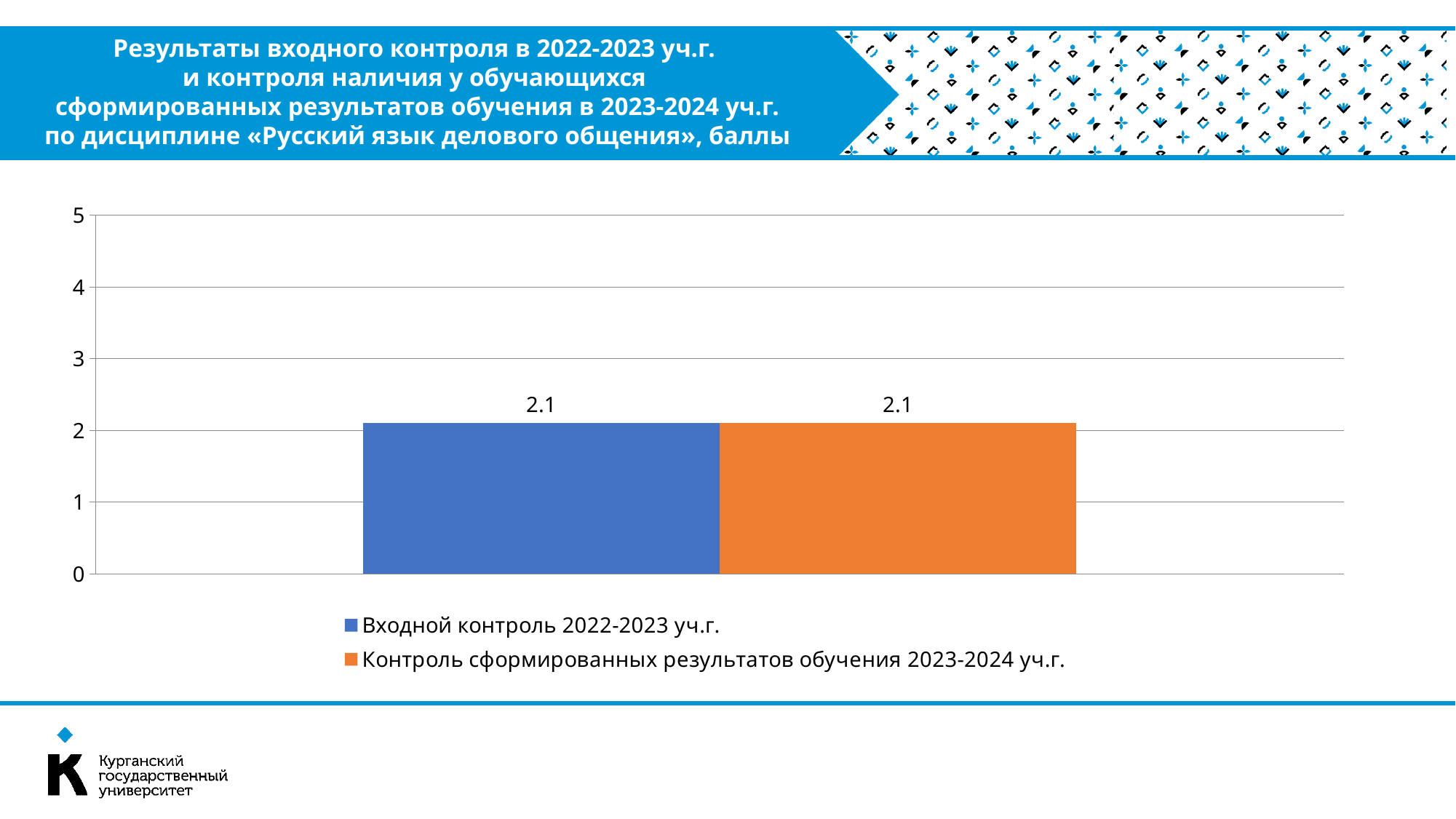
What colour is the bar for Контроль сформированных результатов обучения 2023-2024 уч.г.? orange What is the difference between the value for Входной контроль 2022-2023 уч.г. and the value for Контроль сформированных результатов обучения 2023-2024 уч.г.? 0 What is the highest value shown on the vertical axis? 5 How many bars are plotted on the chart? 2 Is the value for Входной контроль 2022-2023 уч.г. greater or less than 1? greater What kind of chart is shown on the slide? bar chart What is the value for Контроль сформированных результатов обучения 2023-2024 уч.г.? 2.1 Is the value for Контроль сформированных результатов обучения 2023-2024 уч.г. greater or less than 3? less How many series does the legend list? 2 What is the value for Входной контроль 2022-2023 уч.г.? 2.1 Is the value for Входной контроль 2022-2023 уч.г. larger than, smaller than, or equal to the value for Контроль сформированных результатов обучения 2023-2024 уч.г.? equal